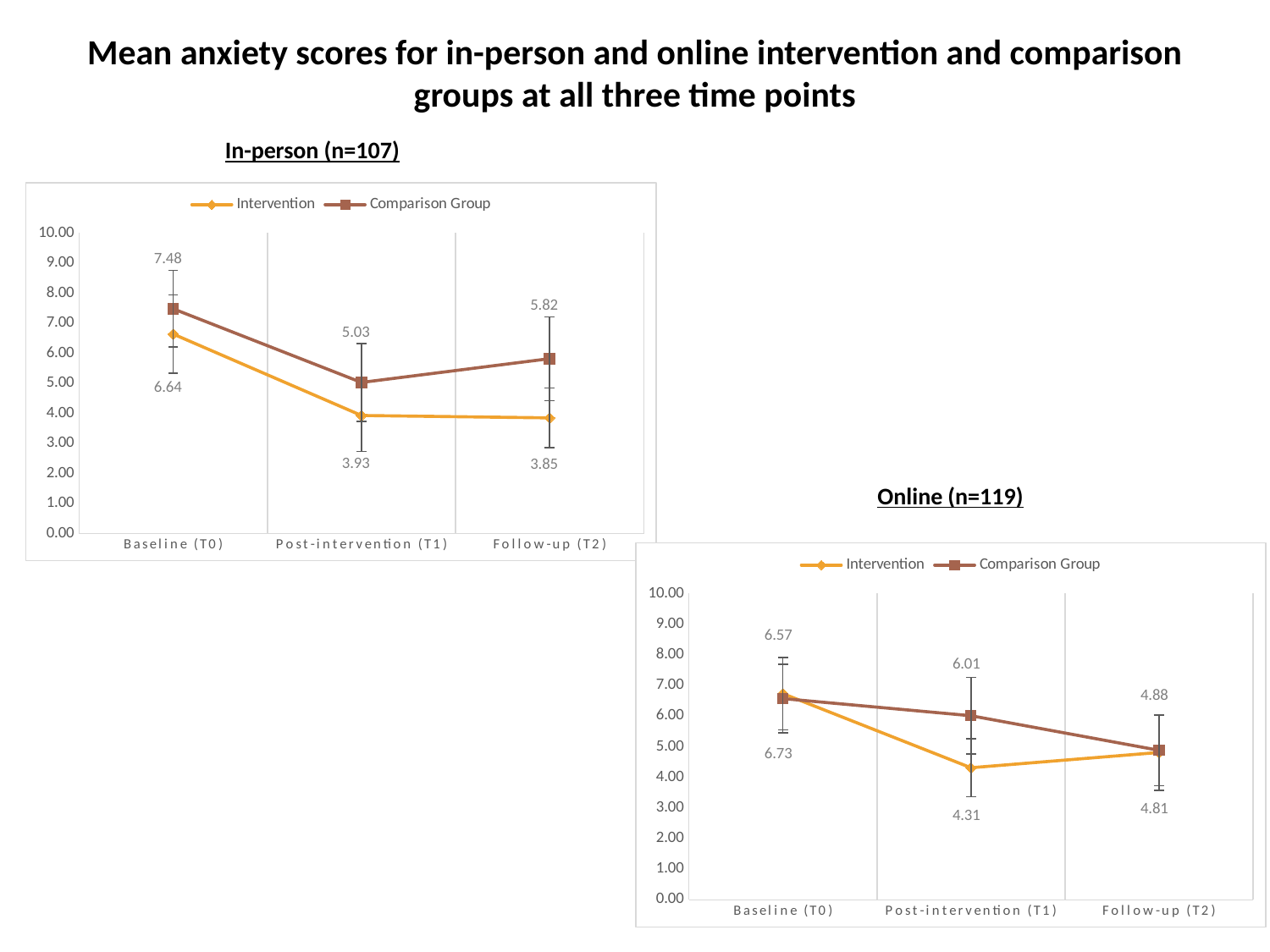
How many series does the legend of the Online (n=119) chart list? 2 In the Online (n=119) chart, what is the Comparison Group value at Baseline (T0)? 6.57 In the Online (n=119) chart, what is the Intervention value at Post-intervention (T1)? 4.31 In the Online (n=119) chart, what is the difference between the Comparison Group and Intervention values at Post-intervention (T1)? 1.70 In the In-person (n=107) chart, what is the difference between the Comparison Group and Intervention values at Baseline (T0)? 0.84 In the In-person (n=107) chart, at which time point is the Intervention value highest? Baseline (T0) In the In-person (n=107) chart, at which time point is the Comparison Group value lowest? Post-intervention (T1) In the In-person (n=107) chart, what is the Comparison Group value at Follow-up (T2)? 5.82 In the In-person (n=107) chart, which series has the larger value at Post-intervention (T1)? Comparison Group In the Online (n=119) chart, does the Intervention value rise or fall from Baseline (T0) to Post-intervention (T1)? Fall What kind of chart is the In-person (n=107) chart? Line chart In the In-person (n=107) chart, what is the Intervention value at Baseline (T0)? 6.64